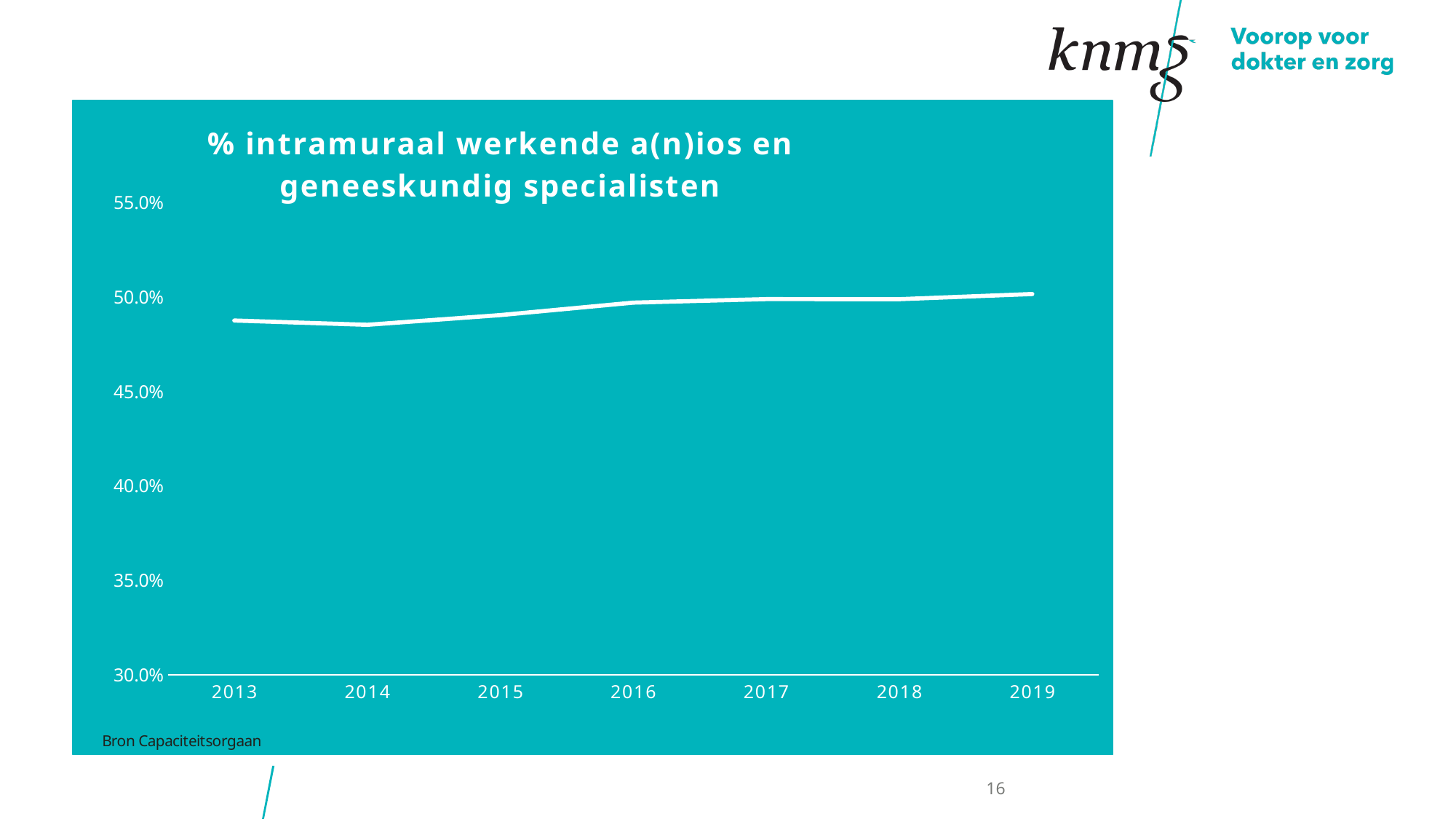
Is the value for 2013 greater or less than 50.0%? less Does the line generally rise or fall from 2013 to 2019? rise How many years are plotted along the x axis? 7 Is the value for 2019 greater or less than 45.0%? greater Which is larger, the value for 2013 or the value for 2016? 2016 What is the first year shown on the x axis? 2013 What is the title of the chart? % intramuraal werkende a(n)ios en geneeskundig specialisten What source is cited below the chart? Bron Capaciteitsorgaan What kind of chart is shown on the slide? line chart Which is larger, the value for 2014 or the value for 2019? 2019 Is the value for 2014 greater or less than 50.0%? less